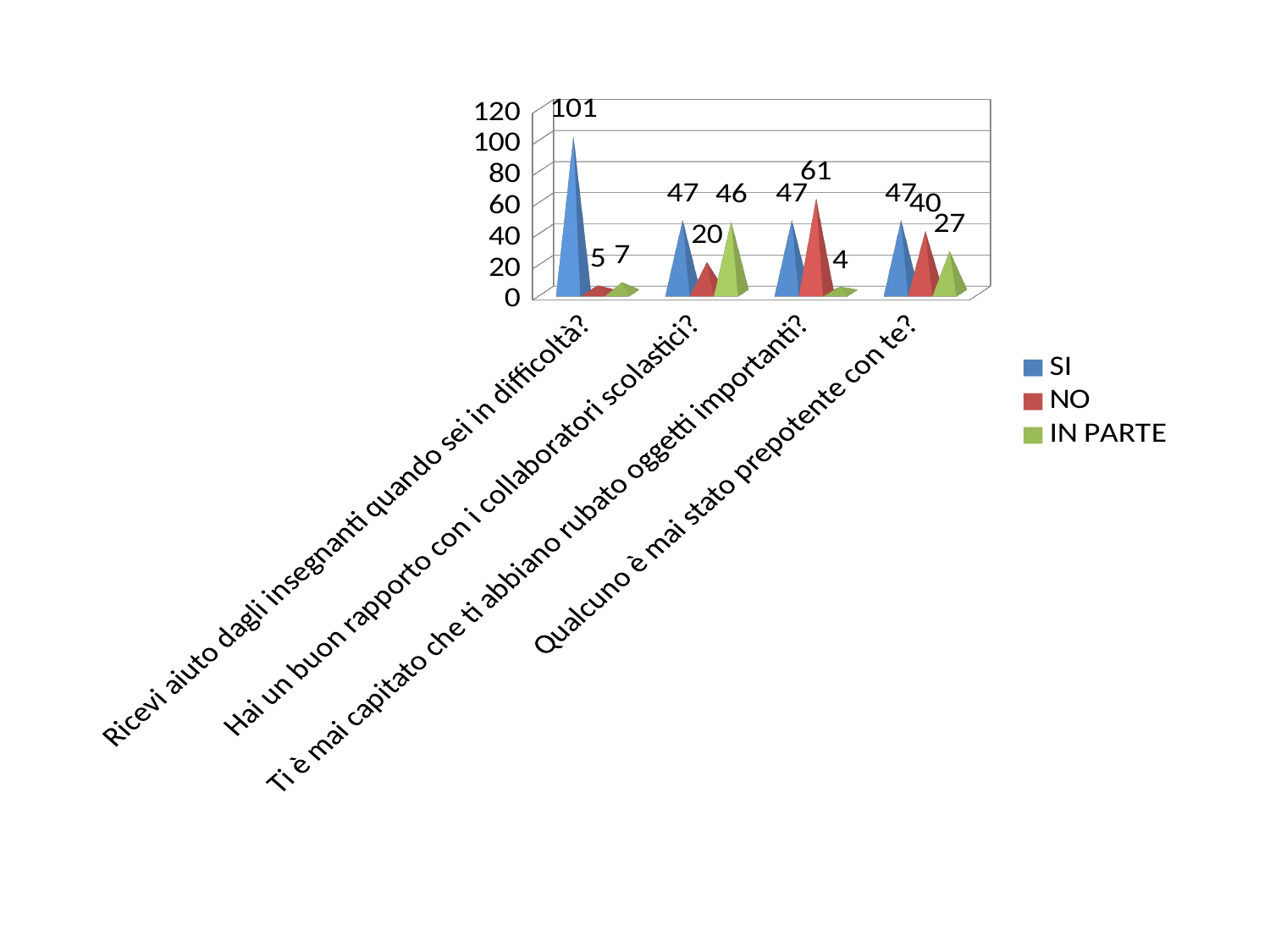
How many questions (categories) are shown on the x axis? 4 What is the IN PARTE value for "Qualcuno è mai stato prepotente con te?"? 27 For "Qualcuno è mai stato prepotente con te?", which is larger, the SI value or the NO value? SI What is the IN PARTE value for "Hai un buon rapporto con i collaboratori scolastici?"? 46 Which question has the highest SI value? Ricevi aiuto dagli insegnanti quando sei in difficoltà? Which question has the lowest IN PARTE value? Ti è mai capitato che ti abbiano rubato oggetti importanti? What kind of chart is shown on the slide? Bar chart How many series does the legend list? 3 What is the NO value for "Ti è mai capitato che ti abbiano rubato oggetti importanti?"? 61 What is the difference between the NO and SI values for "Ti è mai capitato che ti abbiano rubato oggetti importanti?"? 14 What is the difference between the SI and NO values for "Ricevi aiuto dagli insegnanti quando sei in difficoltà?"? 96 What is the SI value for "Ricevi aiuto dagli insegnanti quando sei in difficoltà?"? 101